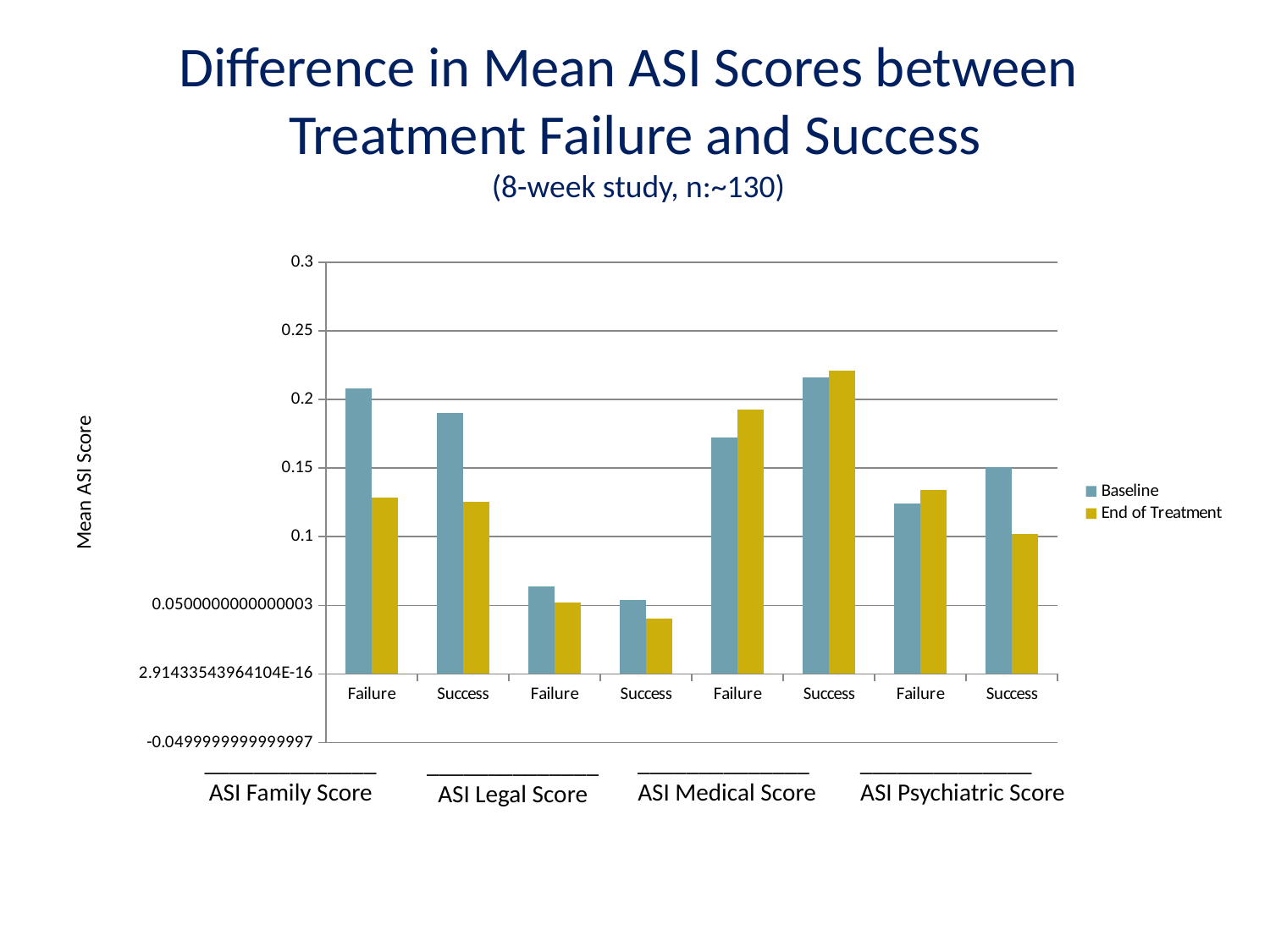
Is the End of Treatment value for ASI Psychiatric Score Success greater or less than 0.15? less For ASI Family Score Failure, which is larger: the Baseline or the End of Treatment value? Baseline For ASI Medical Score Failure, which is larger: the Baseline or the End of Treatment value? End of Treatment Is the End of Treatment value for ASI Legal Score Success greater or less than 0.05? less Which group has the highest End of Treatment bar? ASI Medical Score Success Is the Baseline value for ASI Medical Score Success greater or less than 0.2? greater What are the two series named in the legend? Baseline and End of Treatment What is the title of the vertical axis? Mean ASI Score What kind of chart is shown on the slide? bar chart How many series does the legend list? 2 How many ASI score categories are shown along the bottom of the chart? 4